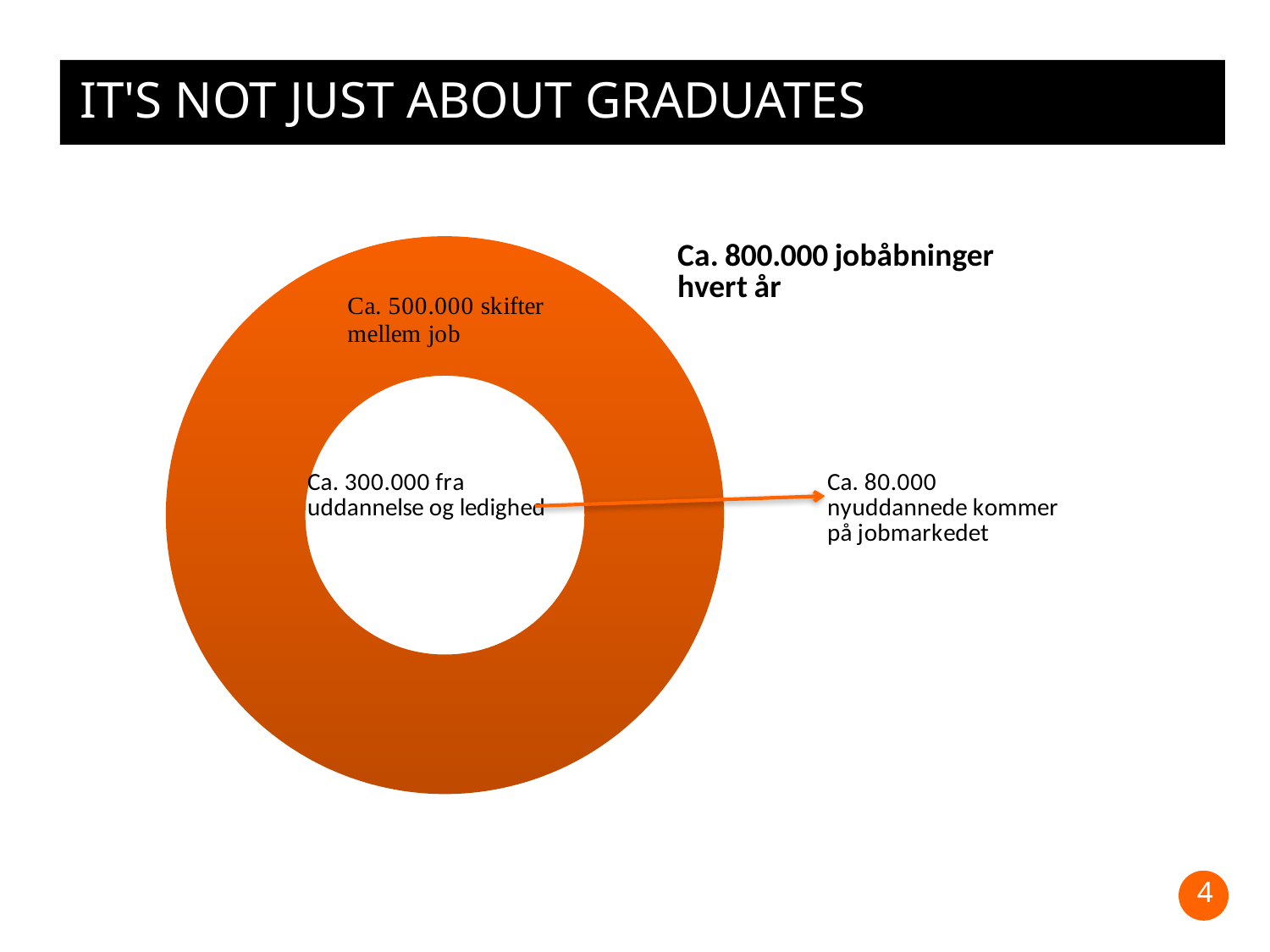
What is the title of the slide? IT'S NOT JUST ABOUT GRADUATES Which is larger: the number who change between jobs or the number from education and unemployment? skifter mellem job What kind of chart is shown on the slide? doughnut chart According to the slide, how many newly graduated people enter the job market (nyuddannede kommer på jobmarkedet)? Ca. 80.000 What colour is the doughnut chart? orange According to the slide, how many come from education and unemployment (fra uddannelse og ledighed)? Ca. 300.000 How many labelled groups of people are shown around the doughnut chart? 3 Which group on the slide has the largest number? skifter mellem job According to the slide, how many people change between jobs (skifter mellem job)? Ca. 500.000 Which group on the slide has the smallest number? nyuddannede kommer på jobmarkedet How many job openings per year (jobåbninger hvert år) does the slide state? Ca. 800.000